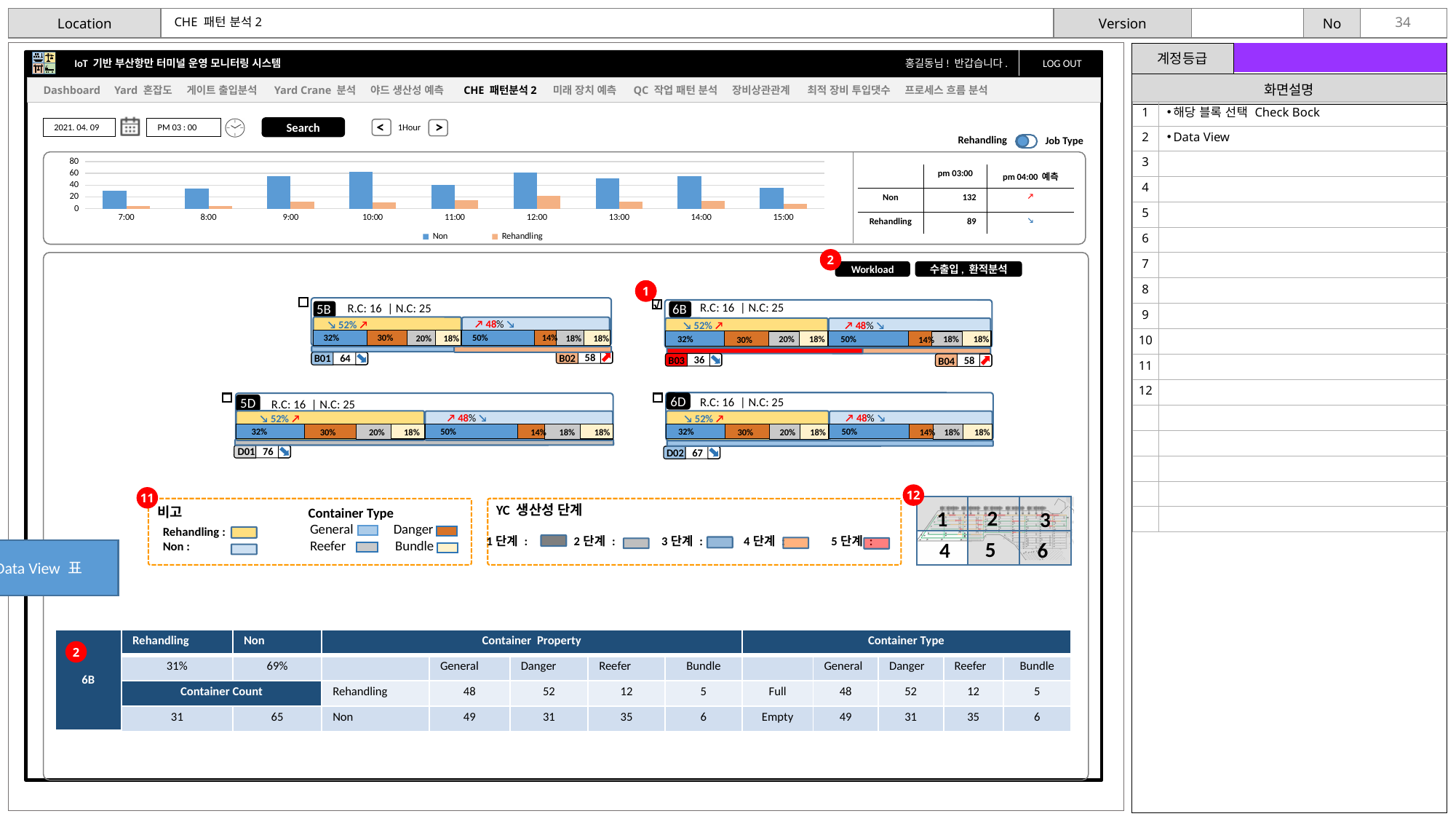
In the top bar chart, what are the two legend entries? Non, Rehandling In the top bar chart, how many time categories are shown on the x axis? 9 In the top bar chart, is the Non value at 10:00 greater or less than 40? greater In the top bar chart, what is the highest value shown on the y axis? 80 In the top bar chart, is the Rehandling value at 9:00 greater or less than 20? less What kind of chart is shown at the top of the slide? bar chart In the top bar chart, is the Non value at 7:00 greater or less than 40? less In the top bar chart, at which time is the Rehandling value highest? 12:00 In the top bar chart, which is larger for the Non series, the value at 10:00 or the value at 11:00? 10:00 In the top bar chart, how many series does the legend list? 2 In the top bar chart, which is larger at 12:00, the Non value or the Rehandling value? Non In the top bar chart, which colour represents the Rehandling series? orange